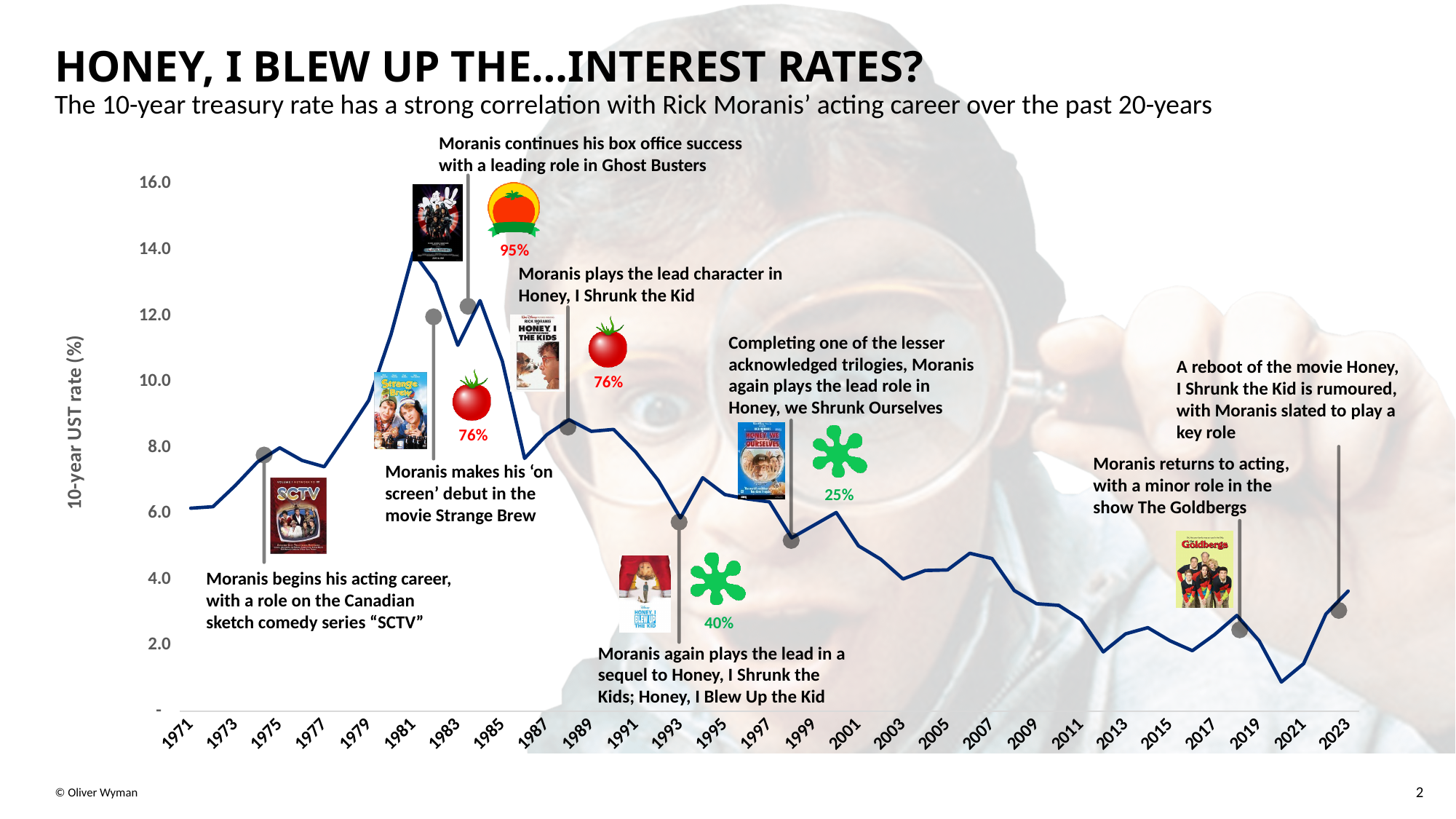
What is the label on the vertical axis of the chart? 10-year UST rate (%) Is the 10-year UST rate in 1993 greater or less than 8.0? less Is the 10-year UST rate in 2013 greater or less than 4.0? less What is the title of the slide containing the chart? HONEY, I BLEW UP THE...INTEREST RATES? In which year on the x axis does the 10-year UST rate reach its highest point? 1981 Is the 10-year UST rate in 2023 greater or less than 2.0? greater Which year has the higher 10-year UST rate, 1981 or 2023? 1981 What kind of chart is shown on the slide? line chart Does the 10-year UST rate generally rise or fall between 1981 and 2021? fall How many year labels are shown on the x axis of the chart? 27